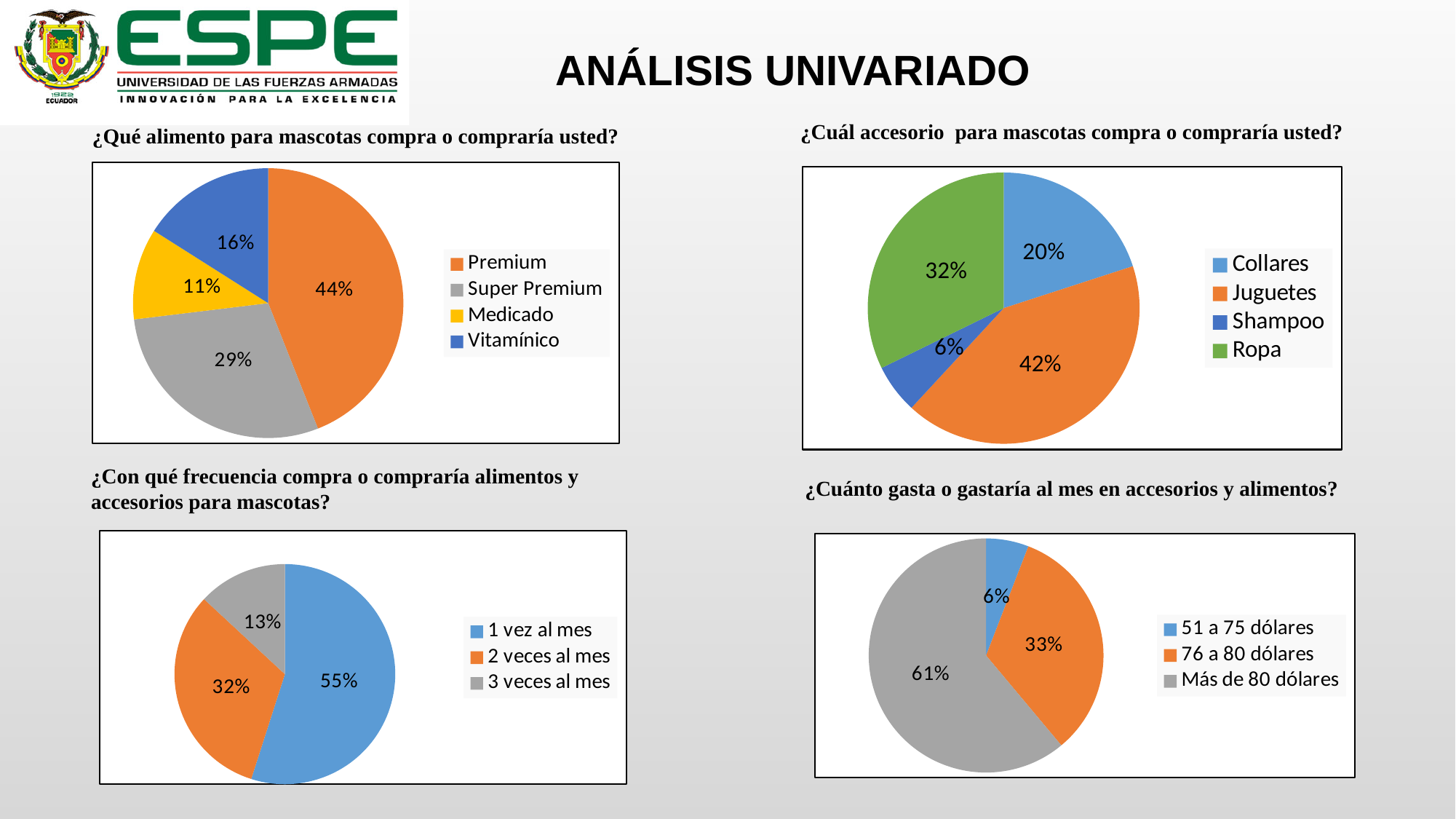
In the top-right pie chart (¿Cuál accesorio para mascotas compra o compraría usted?), how many categories does the legend list? 4 In the top-right pie chart (¿Cuál accesorio para mascotas compra o compraría usted?), which is larger, Collares or Shampoo? Collares In the bottom-left pie chart (¿Con qué frecuencia compra o compraría alimentos y accesorios para mascotas?), which category has the largest slice? 1 vez al mes In the bottom-left pie chart (¿Con qué frecuencia compra o compraría alimentos y accesorios para mascotas?), what share does '2 veces al mes' have? 32% In the bottom-right pie chart (¿Cuánto gasta o gastaría al mes en accesorios y alimentos?), what share does 'Más de 80 dólares' have? 61% In the bottom-right pie chart (¿Cuánto gasta o gastaría al mes en accesorios y alimentos?), what is the difference between '76 a 80 dólares' and '51 a 75 dólares'? 27% In the top-right pie chart (¿Cuál accesorio para mascotas compra o compraría usted?), what share does Ropa have? 32% In the top-left pie chart (¿Qué alimento para mascotas compra o compraría usted?), what is the difference between Super Premium and Vitamínico? 13% In the top-left pie chart (¿Qué alimento para mascotas compra o compraría usted?), which category has the smallest slice? Medicado What type of chart is used in the bottom-right chart (¿Cuánto gasta o gastaría al mes en accesorios y alimentos?)? Pie chart In the top-left pie chart (¿Qué alimento para mascotas compra o compraría usted?), what share does Premium have? 44% In the top-right pie chart (¿Cuál accesorio para mascotas compra o compraría usted?), which category has the largest slice? Juguetes